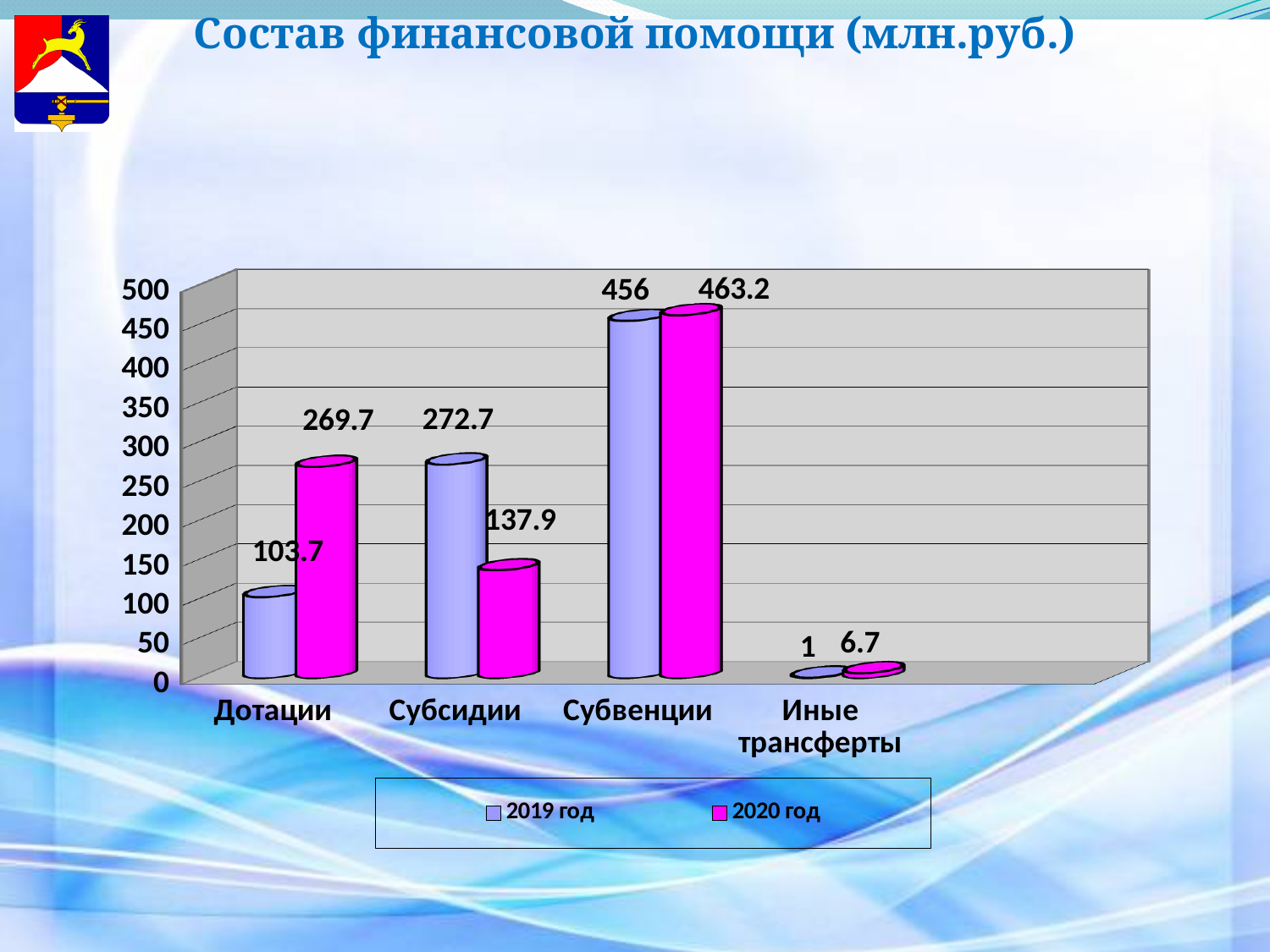
How many series does the legend list? 2 What is the title of the chart? Состав финансовой помощи (млн.руб.) Which category has the highest value in the 2019 год series? Субвенции How many categories are shown on the x axis? 4 What kind of chart is shown on the slide? Bar chart Is the 2020 год value for Субвенции greater or less than 450? greater What is the value for Субсидии in the 2019 год series? 272.7 Which is larger for Субсидии: the 2019 год value or the 2020 год value? 2019 год What is the value for Иные трансферты in the 2020 год series? 6.7 What is the value for Дотации in the 2020 год series? 269.7 Which category has the lowest value in the 2020 год series? Иные трансферты What is the difference between the 2020 год and 2019 год values for Дотации? 166